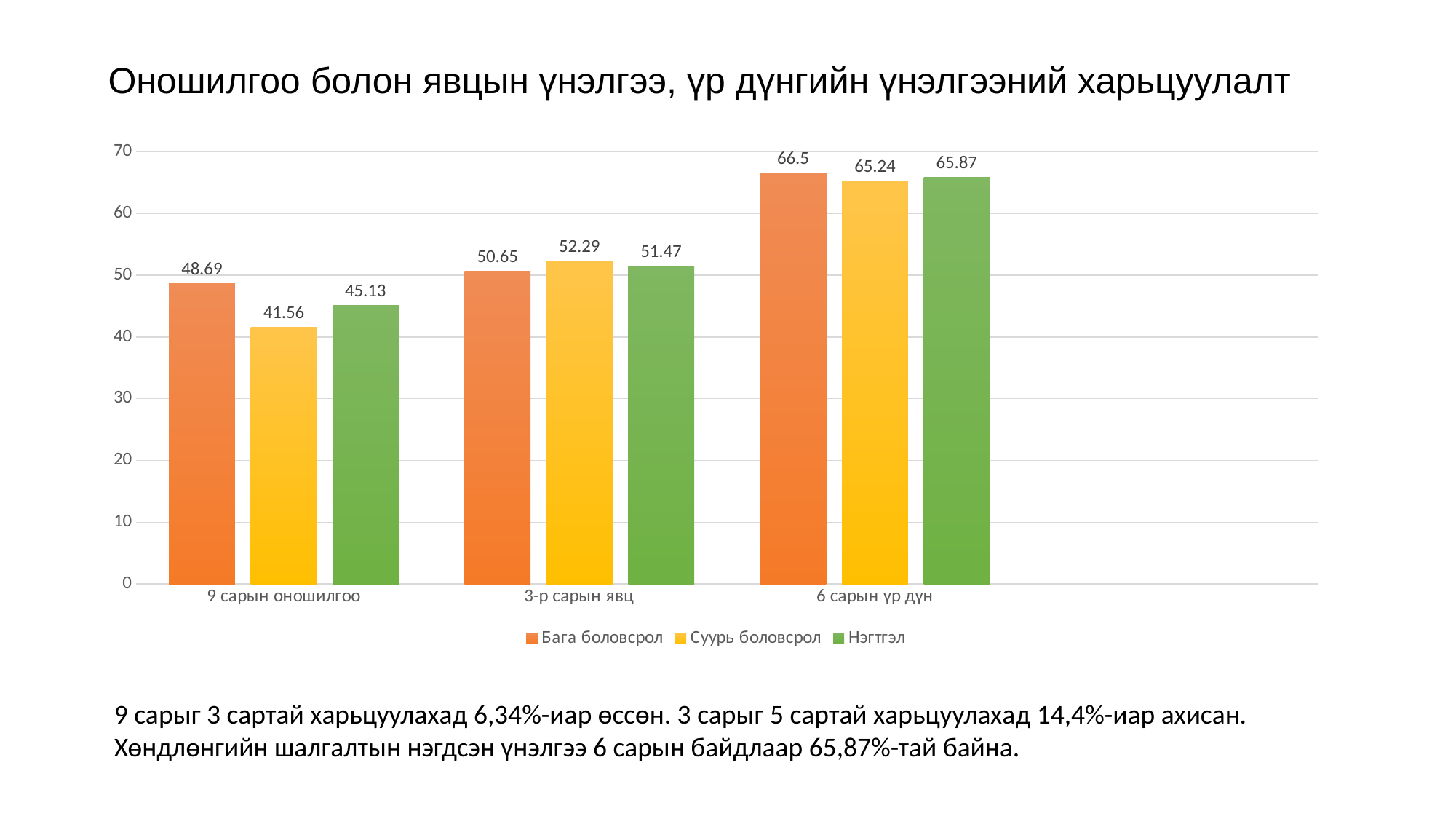
How many series does the legend list? 3 What kind of chart is shown on the slide? bar chart What is the difference between the Нэгтгэл values for 6 сарын үр дүн and 9 сарын оношилгоо? 20.74 In the 9 сарын оношилгоо category, which is larger: Бага боловсрол or Суурь боловсрол? Бага боловсрол Which category has the highest value for the Бага боловсрол series? 6 сарын үр дүн Do the Нэгтгэл values rise or fall from 9 сарын оношилгоо to 6 сарын үр дүн? rise Which category has the lowest value for the Суурь боловсрол series? 9 сарын оношилгоо What is the value for Суурь боловсрол in the 3-р сарын явц category? 52.29 What is the value for Нэгтгэл in the 6 сарын үр дүн category? 65.87 What is the value for Бага боловсрол in the 9 сарын оношилгоо category? 48.69 Is the value for Суурь боловсрол in the 9 сарын оношилгоо category greater or less than 50? less How many categories are shown on the x axis? 3